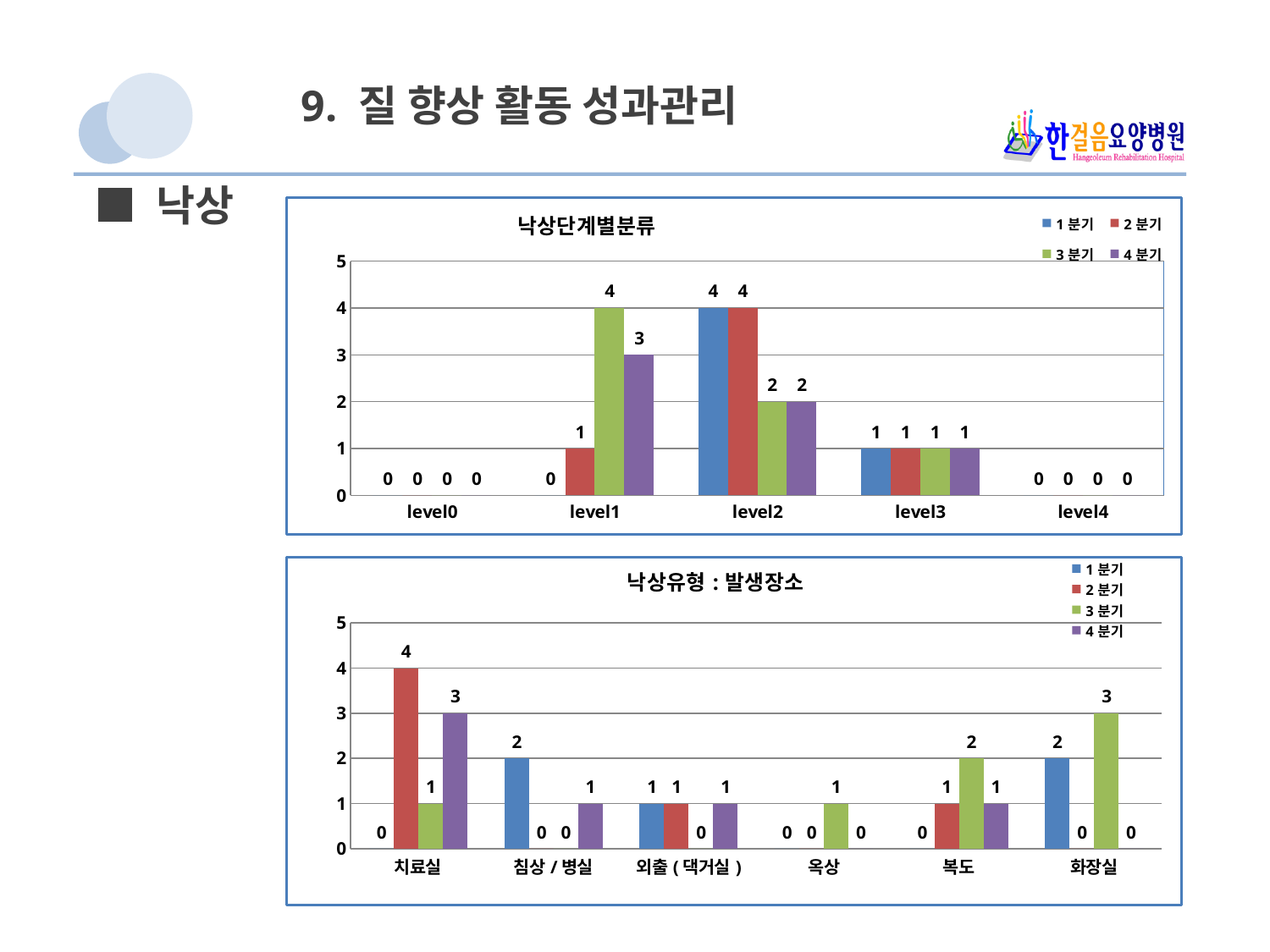
In the top chart titled 낙상단계별분류, what is the value for 1 분기 at level2? 4 In the top chart titled 낙상단계별분류, what is the value for 3 분기 at level1? 4 What type of chart is the bottom chart titled 낙상유형 : 발생장소? bar chart In the top chart titled 낙상단계별분류, what is the difference between the 3 분기 value at level1 and the 3 분기 value at level2? 2 In the top chart titled 낙상단계별분류, which category has the highest value for 4 분기? level1 In the bottom chart titled 낙상유형 : 발생장소, which is larger: the 2 분기 value at 치료실 or the 4 분기 value at 치료실? 2 분기 value at 치료실 In the top chart titled 낙상단계별분류, how many series does the legend list? 4 In the bottom chart titled 낙상유형 : 발생장소, what is the value for 3 분기 at 화장실? 3 In the bottom chart titled 낙상유형 : 발생장소, what is the value for 2 분기 at 치료실? 4 In the bottom chart titled 낙상유형 : 발생장소, how many categories are shown on the x axis? 6 In the top chart titled 낙상단계별분류, how many categories are shown on the x axis? 5 In the bottom chart titled 낙상유형 : 발생장소, which category has the highest value for 3 분기? 화장실